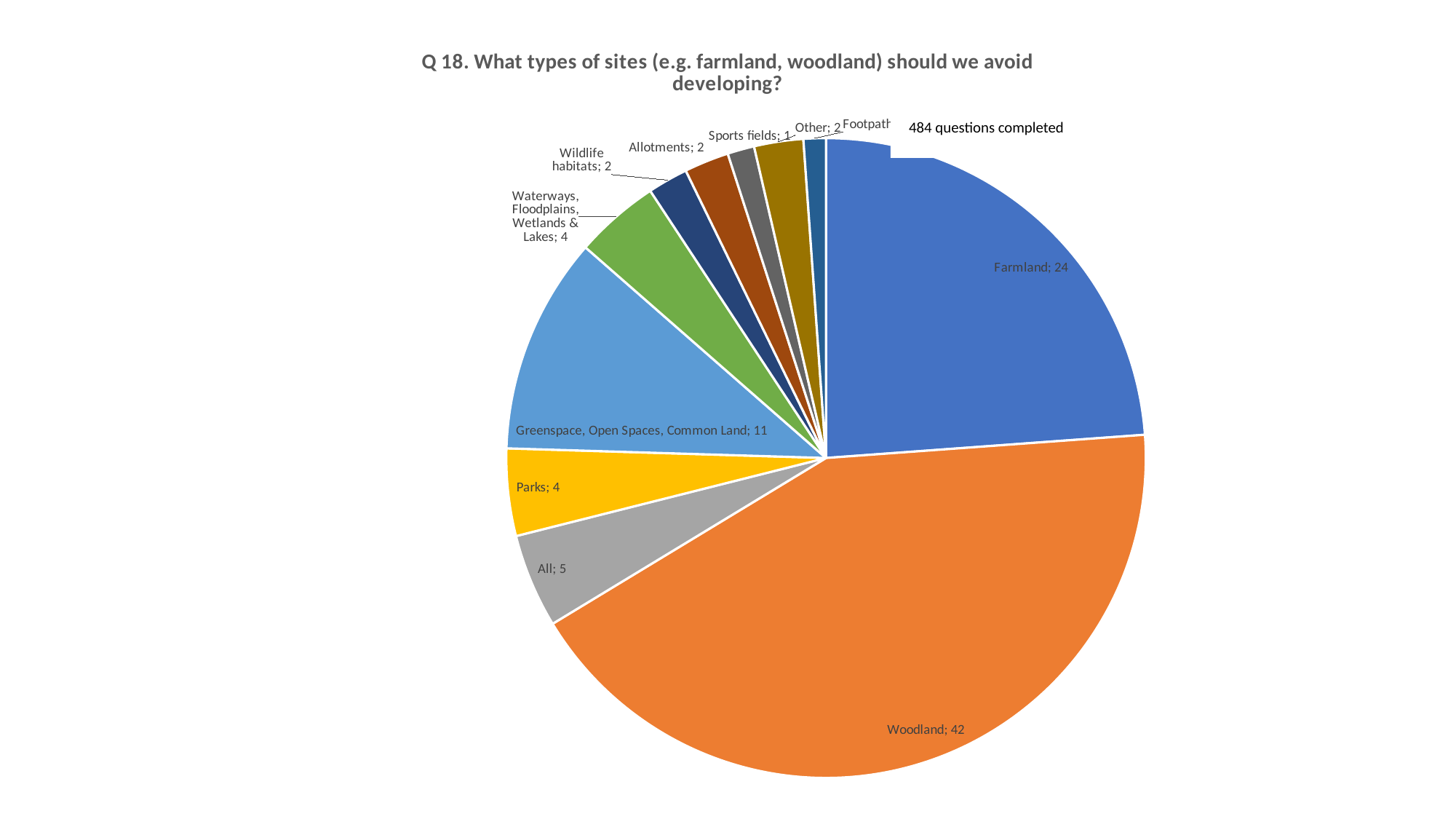
According to the note on the slide, how many questions were completed? 484 What value is shown for Farmland? 24 Which category has the largest slice of the pie? Woodland What value is shown for Sports fields? 1 Which is larger, the value for Greenspace, Open Spaces, Common Land or the value for All? Greenspace, Open Spaces, Common Land What value is shown for Woodland? 42 What value is shown for Greenspace, Open Spaces, Common Land? 11 What kind of chart is shown on the slide? Pie chart What is the difference between the values for Woodland and Farmland? 18 How many slices does the pie chart have? 11 What value is shown for Waterways, Floodplains, Wetlands & Lakes? 4